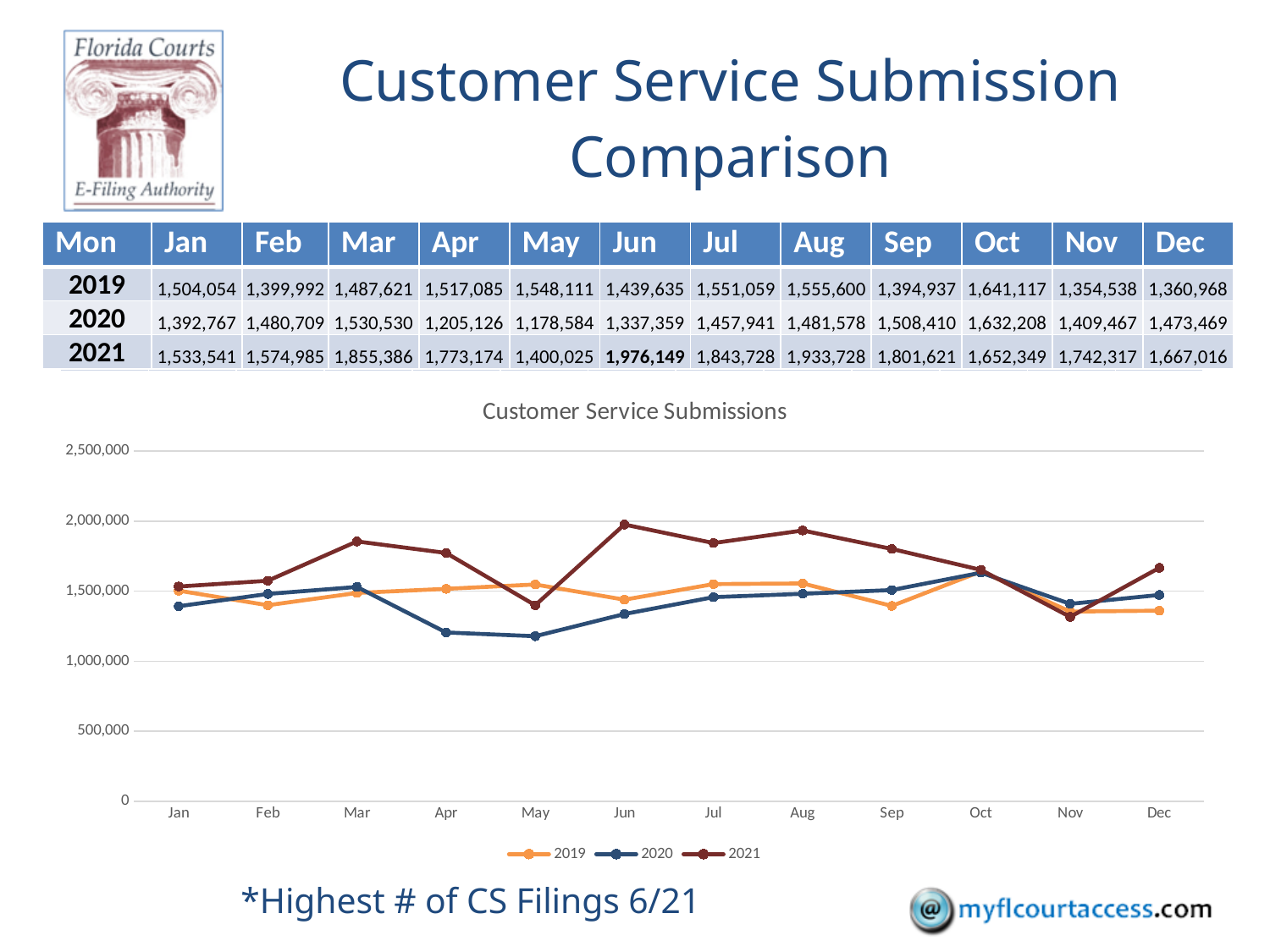
Is the value for 2020 in May greater or less than 1,500,000? less In which month does the 2021 series reach its highest value? Jun What is the value for 2021 in Jun? 1,976,149 What is the value for 2019 in Oct? 1,641,117 What kind of chart is shown? line chart Which is larger in Apr, the 2019 value or the 2020 value? 2019 What is the value for 2020 in May? 1,178,584 What is the difference between the 2021 and 2020 values in Jun? 638,790 In which month does the 2020 series have its lowest value? May How many months are plotted along the x axis? 12 Does the 2021 series rise or fall from Jan to Mar? rise How many series does the legend list? 3